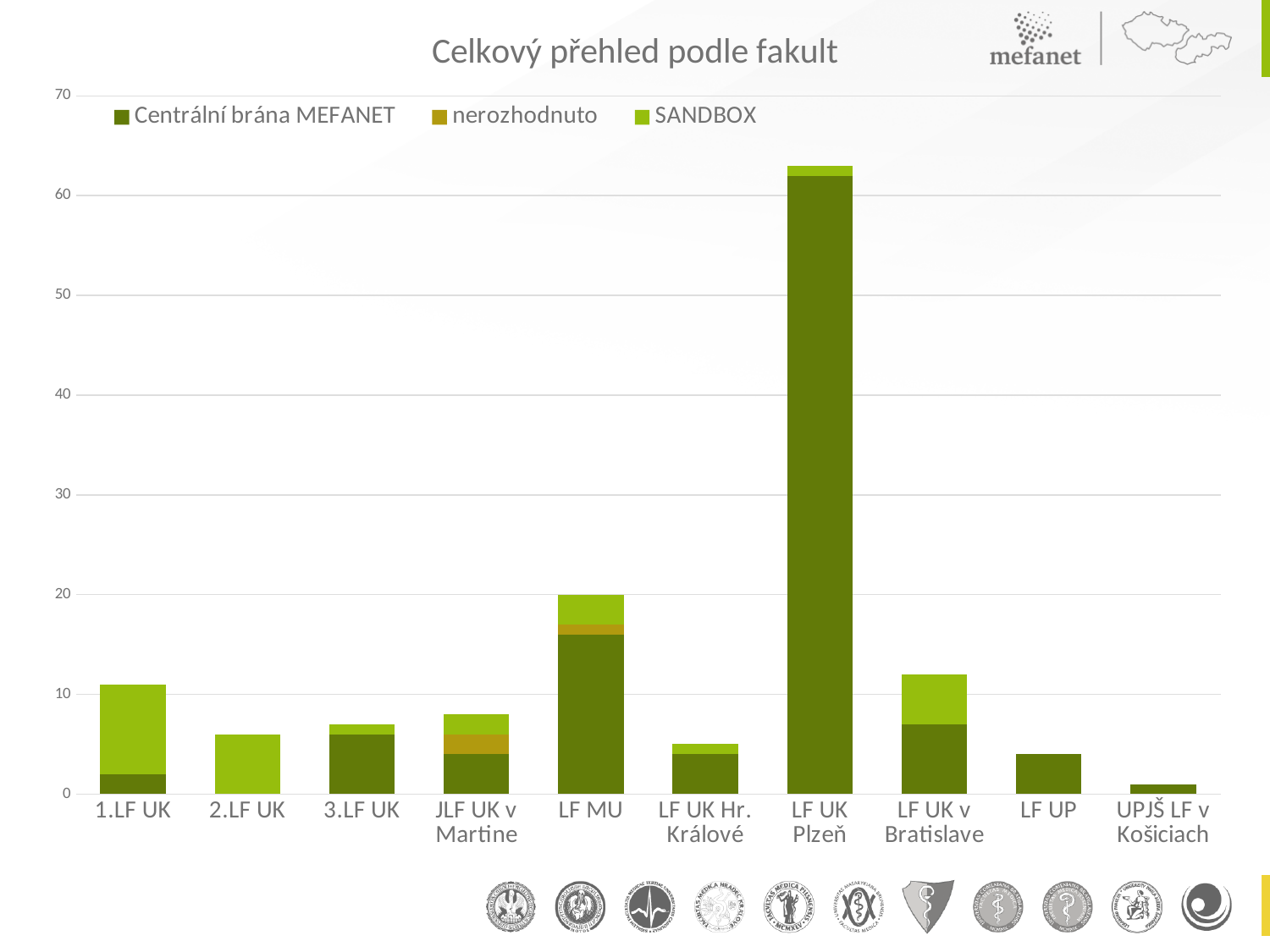
Which legend entry is shown in the lightest green colour? SANDBOX Is the total value for 1.LF UK greater or less than 10? greater Which faculty has the lowest total bar? UPJŠ LF v Košiciach How many faculties (categories) are shown on the x axis? 10 Is the total value for LF UK Plzeň greater or less than 60? greater Is the total value for LF UP greater or less than 10? less Which has the larger total bar, LF MU or LF UK v Bratislave? LF MU How many series does the legend list? 3 Which has the larger total bar, 2.LF UK or 1.LF UK? 1.LF UK What is the title of the chart? Celkový přehled podle fakult Which faculty has the highest total bar? LF UK Plzeň What kind of chart is shown on the slide? stacked bar chart